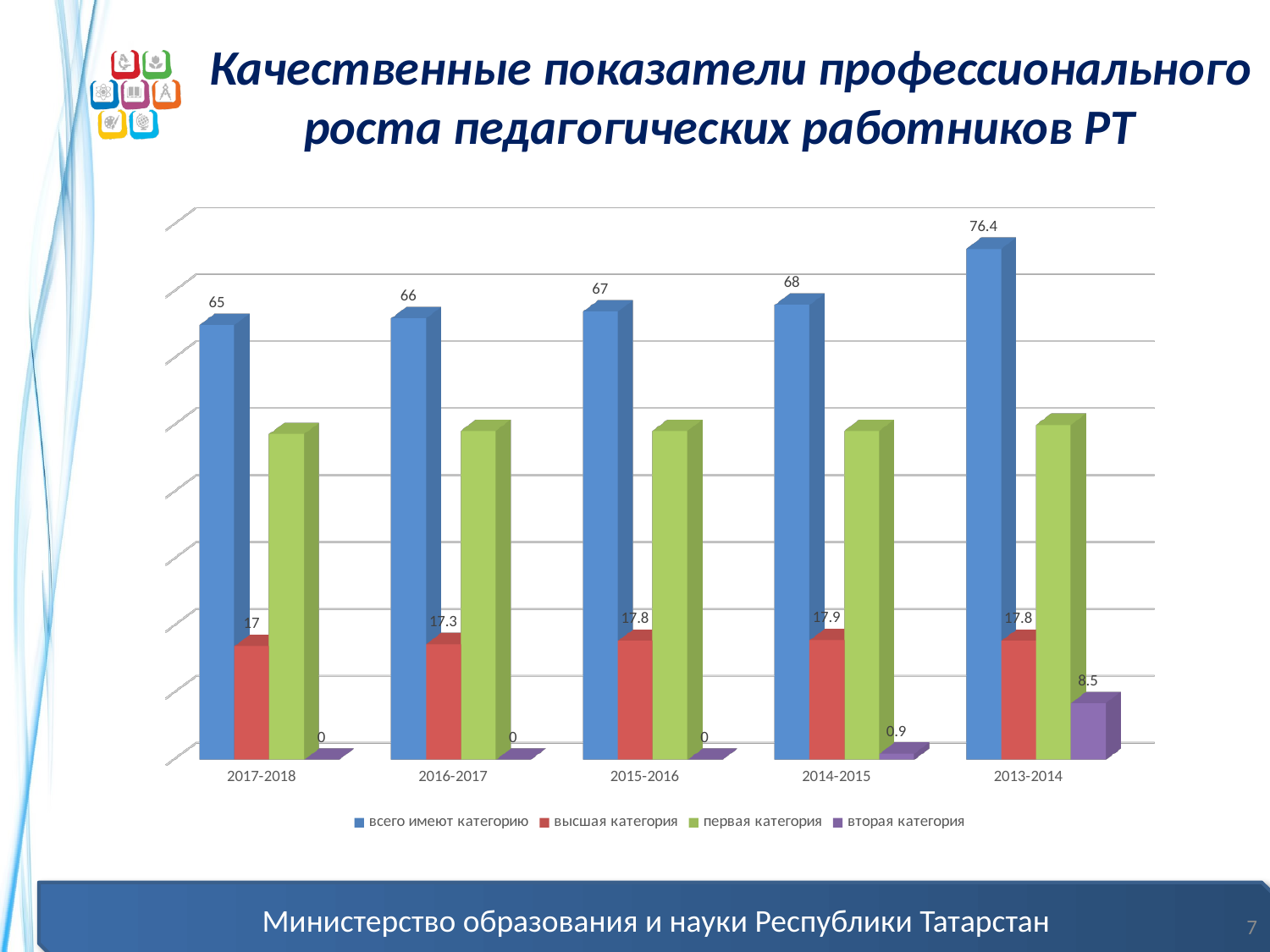
What is the difference between the всего имеют категорию values for 2013-2014 and 2017-2018? 11.4 What is the value for вторая категория in 2013-2014? 8.5 What kind of chart is shown on the slide? bar chart What is the value for вторая категория in 2014-2015? 0.9 Which year has the larger value for высшая категория: 2016-2017 or 2015-2016? 2015-2016 How many year categories are shown on the x axis? 5 Do the values for всего имеют категорию rise or fall from left to right along the x axis? rise What is the value for всего имеют категорию in 2013-2014? 76.4 In which year is the value for всего имеют категорию the lowest? 2017-2018 How many series does the legend list? 4 What is the value for высшая категория in 2014-2015? 17.9 In which year is the value for всего имеют категорию the highest? 2013-2014